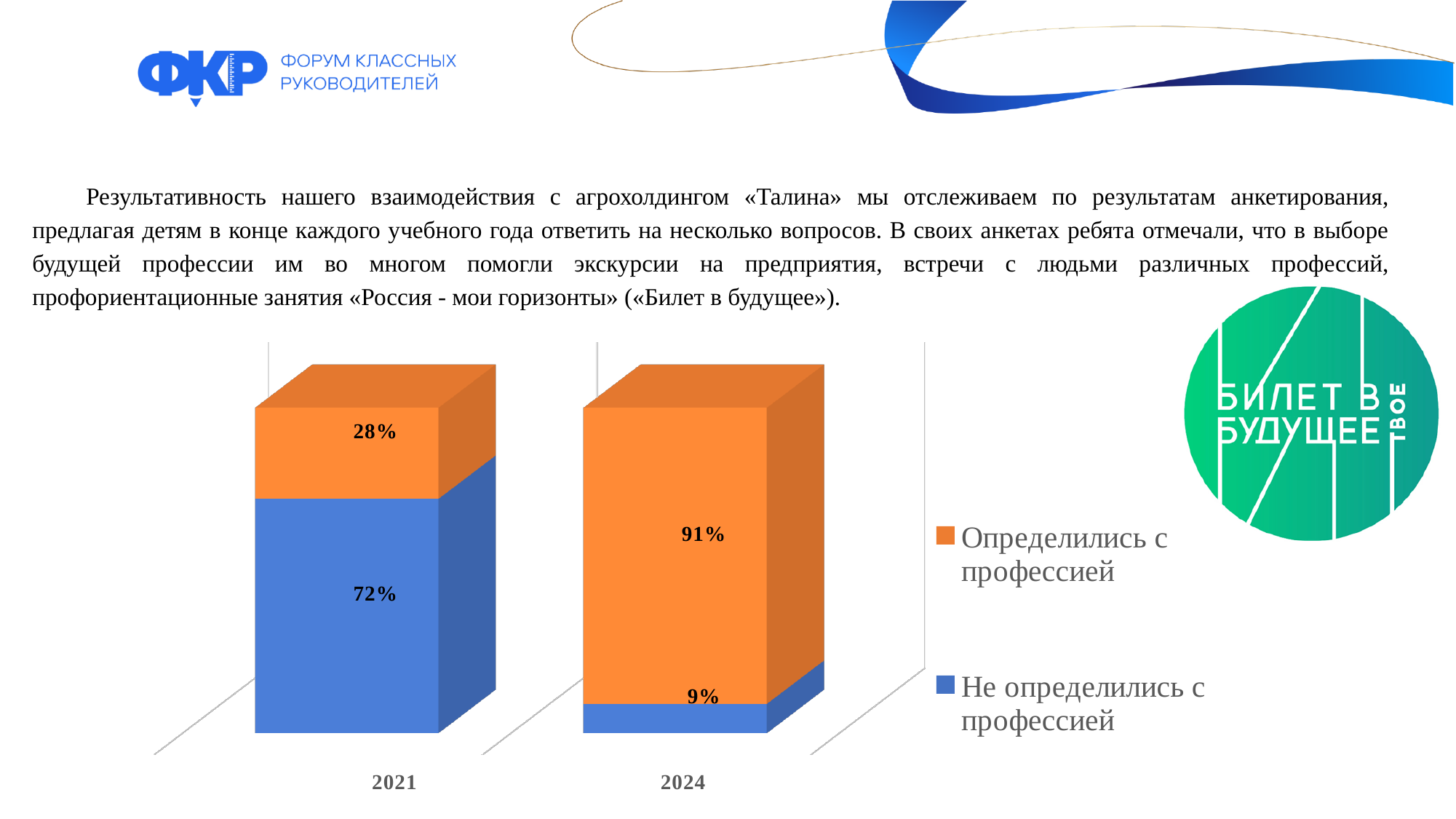
What kind of chart is shown on the slide? Stacked bar chart How many series does the legend list? 2 What is the value for "Определились с профессией" in 2024? 91% In which year is the share of "Определились с профессией" highest? 2024 How many years (categories) are shown on the x axis? 2 What is the value for "Не определились с профессией" in 2024? 9% What is the difference between the "Определились с профессией" values for 2024 and 2021? 63% What is the value for "Не определились с профессией" in 2021? 72% Which is larger in 2021: "Определились с профессией" or "Не определились с профессией"? Не определились с профессией Which colour represents "Не определились с профессией" in the chart? Blue What is the value for "Определились с профессией" in 2021? 28% In which year is the share of "Не определились с профессией" lowest? 2024